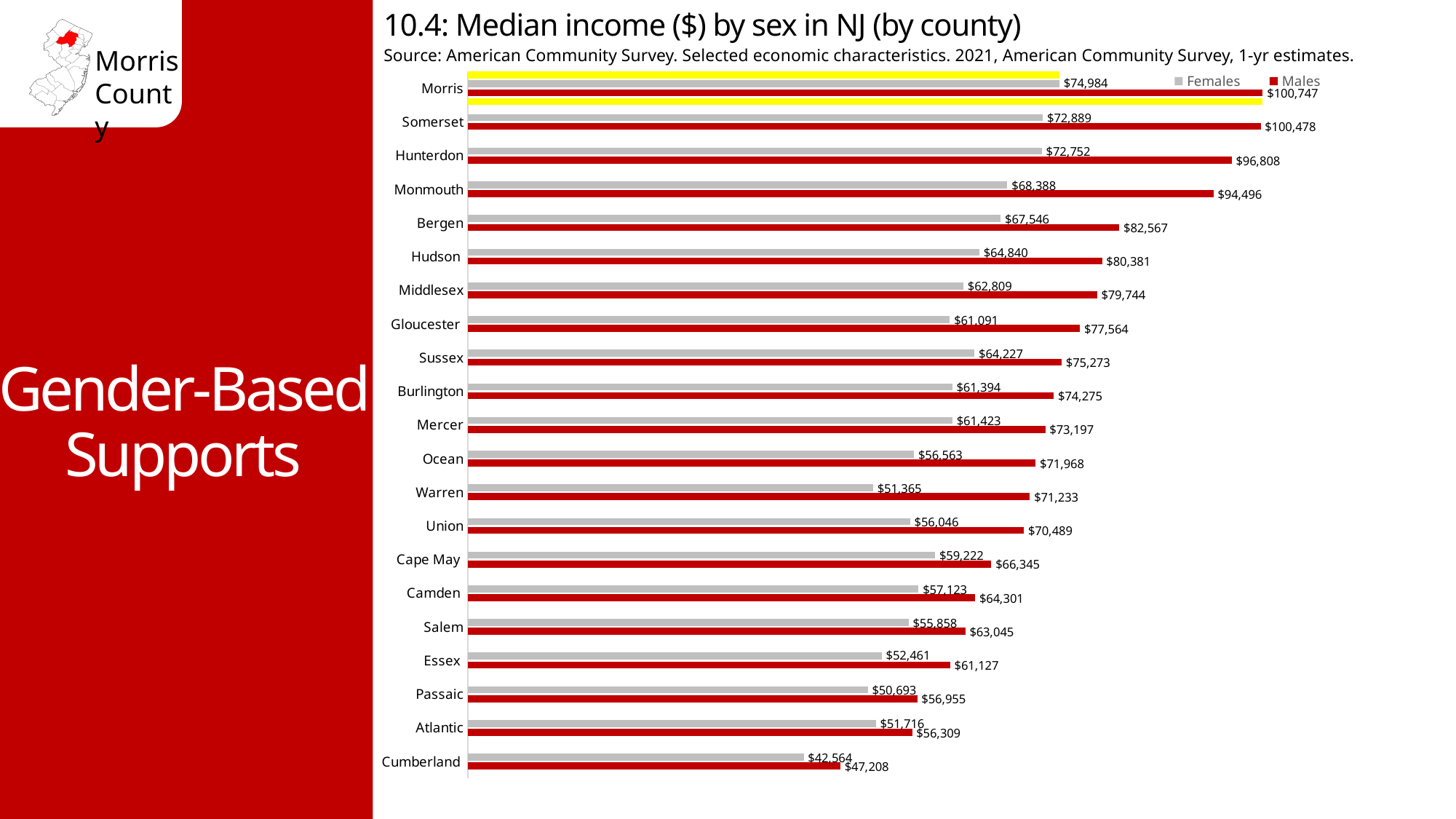
How many counties are shown in the chart? 21 Which county has the highest median income for females? Morris What is the median income for females in Cumberland County? $42,564 What is the difference between male and female median income in Cumberland County? $4,644 Which colour represents Males in the chart? Red Which county has the lowest median income for males? Cumberland What is the median income for males in Morris County? $100,747 Which is larger: the female median income in Sussex or in Middlesex? Sussex How many series does the legend list? 2 What is the median income for females in Hunterdon County? $72,752 What kind of chart is shown on the slide? Bar chart What is the difference between male and female median income in Morris County? $25,763